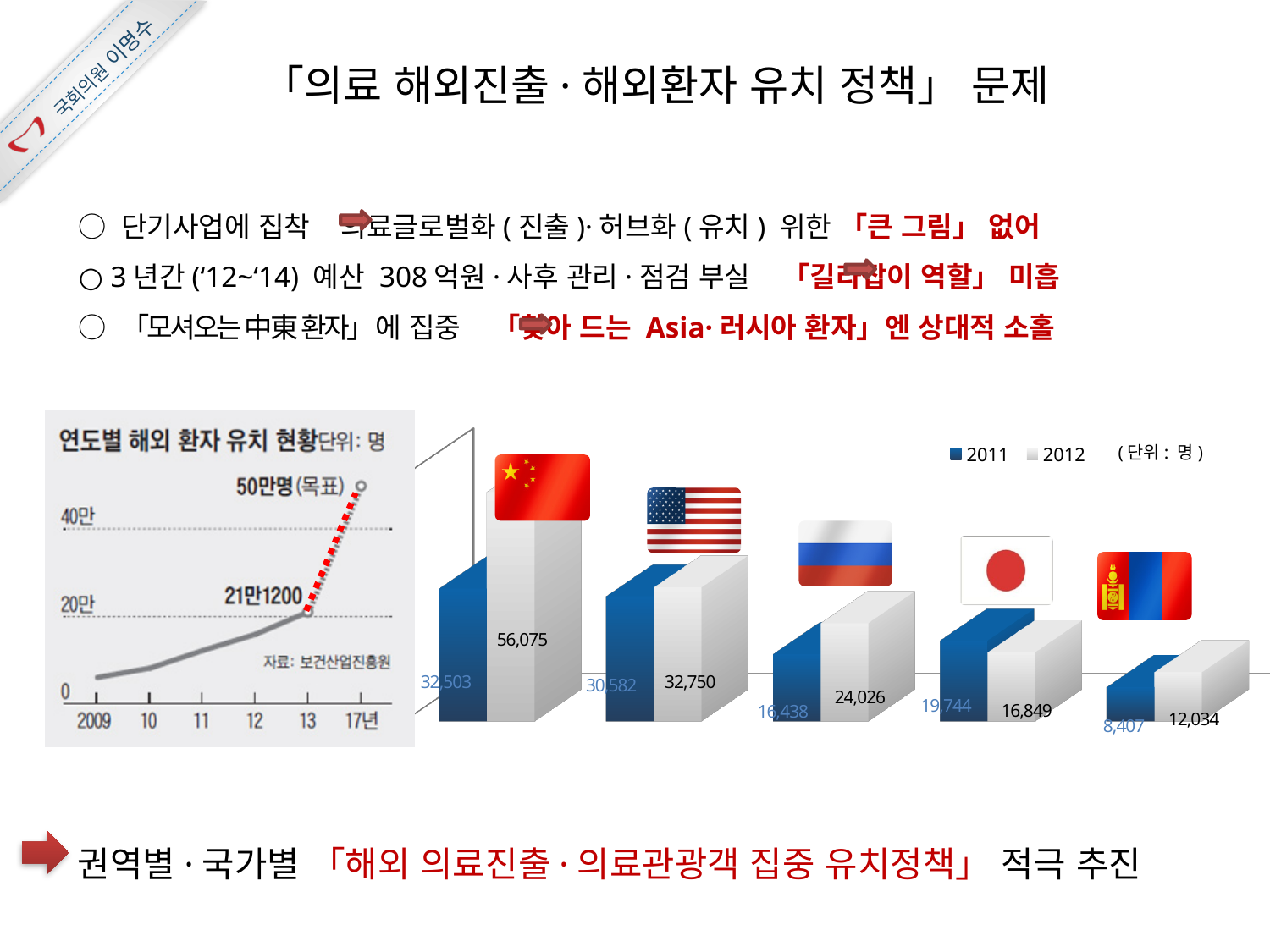
In the bar chart on the right, which country has the highest 2012 value? China In the bar chart on the right, which country has the lowest 2011 value? Mongolia What kind of chart is the chart on the left titled 연도별 해외 환자 유치 현황? Line chart In the bar chart on the right, for the country with the Japanese flag, is the 2011 value or the 2012 value larger? 2011 How many series does the legend of the bar chart on the right list? 2 In the bar chart on the right, what is the 2011 value for the country shown with the US flag? 30,582 In the bar chart on the right, what is the difference between the 2012 and 2011 values for the country with the Chinese flag? 23,572 In the line chart on the left, what is the target value (목표) shown for 17년? 50만명 In the line chart on the left, what value is labelled for the year 13? 21만1200 How many countries are shown in the bar chart on the right? 5 In the bar chart on the right, what is the 2012 value for the country shown with the Mongolian flag? 12,034 In the bar chart on the right, what is the 2012 value for the country shown with the Chinese flag? 56,075